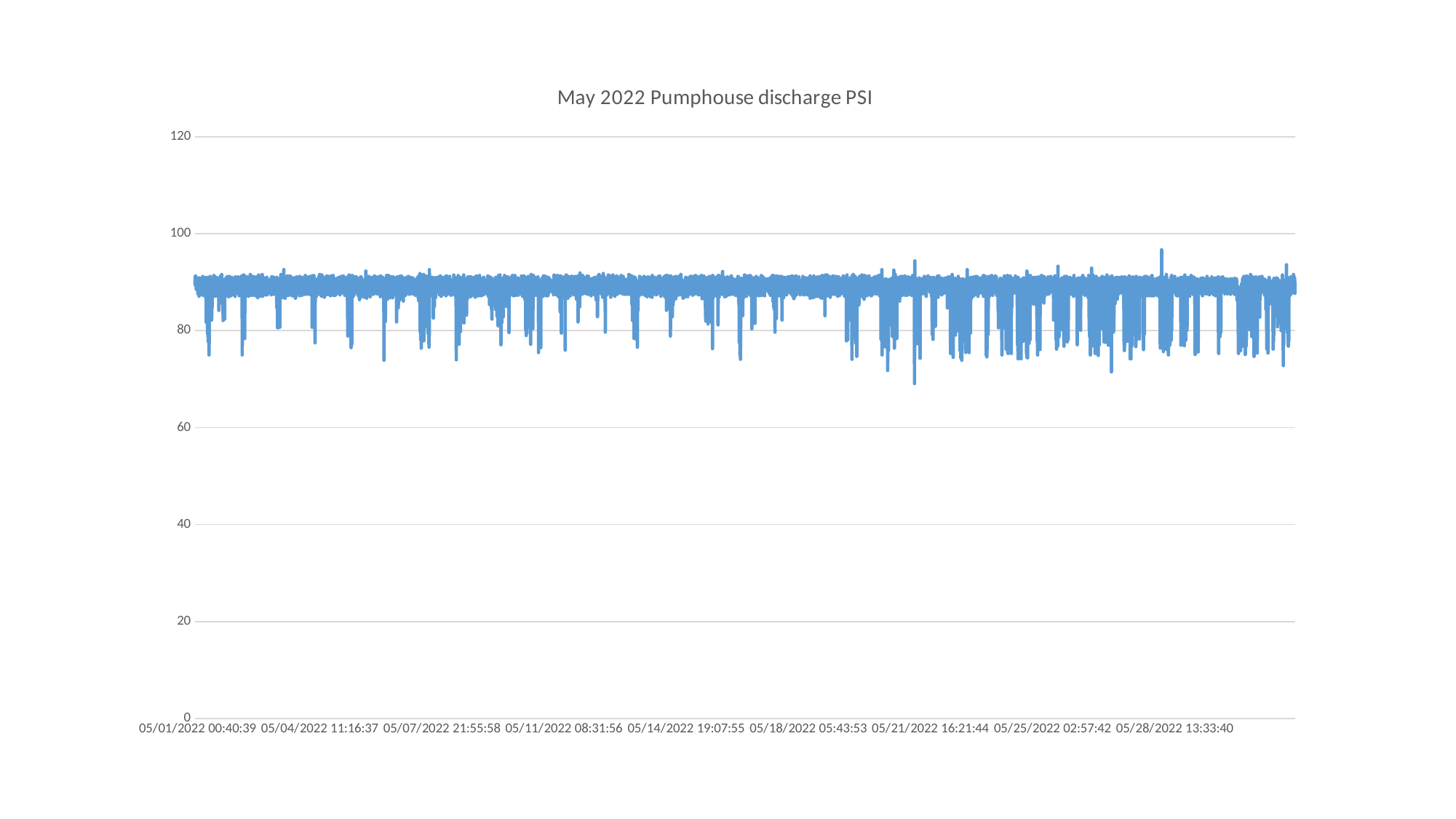
Is the value at 05/14/2022 19:07:55 greater or less than 40? greater What kind of chart is shown on the slide? line chart Is the value at 05/07/2022 21:55:58 greater or less than 100? less Is the value at 05/01/2022 00:40:39 greater or less than 60? greater What is the highest value labelled on the vertical axis? 120 What is the title of the chart? May 2022 Pumphouse discharge PSI